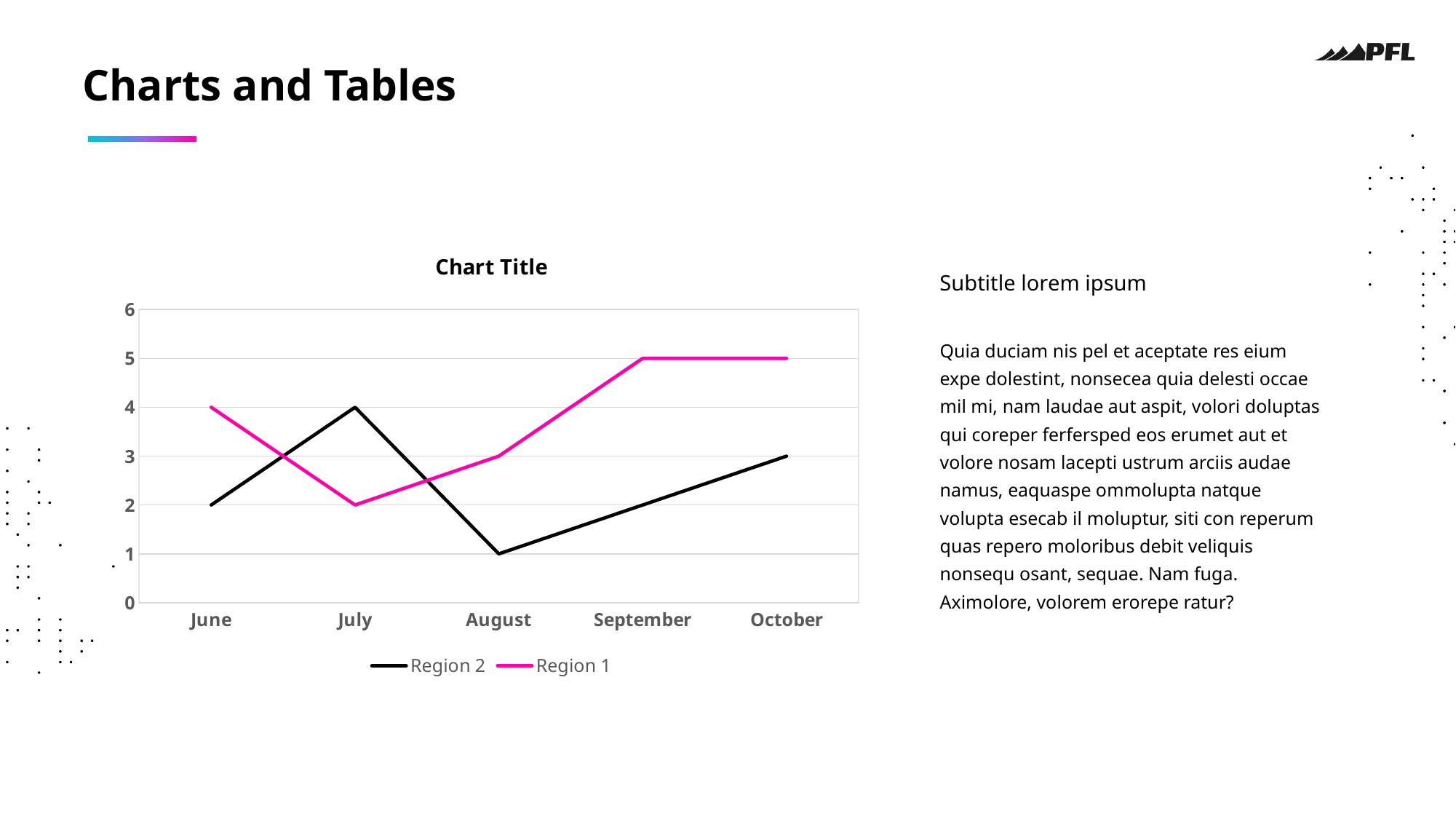
What is the difference between Region 1 and Region 2 in October? 2 What is the value for Region 2 in October? 3 In which month is Region 1 at its lowest? July Which colour is used for the Region 1 line? pink In which month is Region 2 at its highest? July What kind of chart is shown on the slide? line chart What is the value for Region 1 in September? 5 How many months are shown on the x axis of the chart? 5 What is the value for Region 1 in June? 4 How many series does the chart legend list? 2 Which series has the larger value in July, Region 1 or Region 2? Region 2 What is the value for Region 2 in August? 1